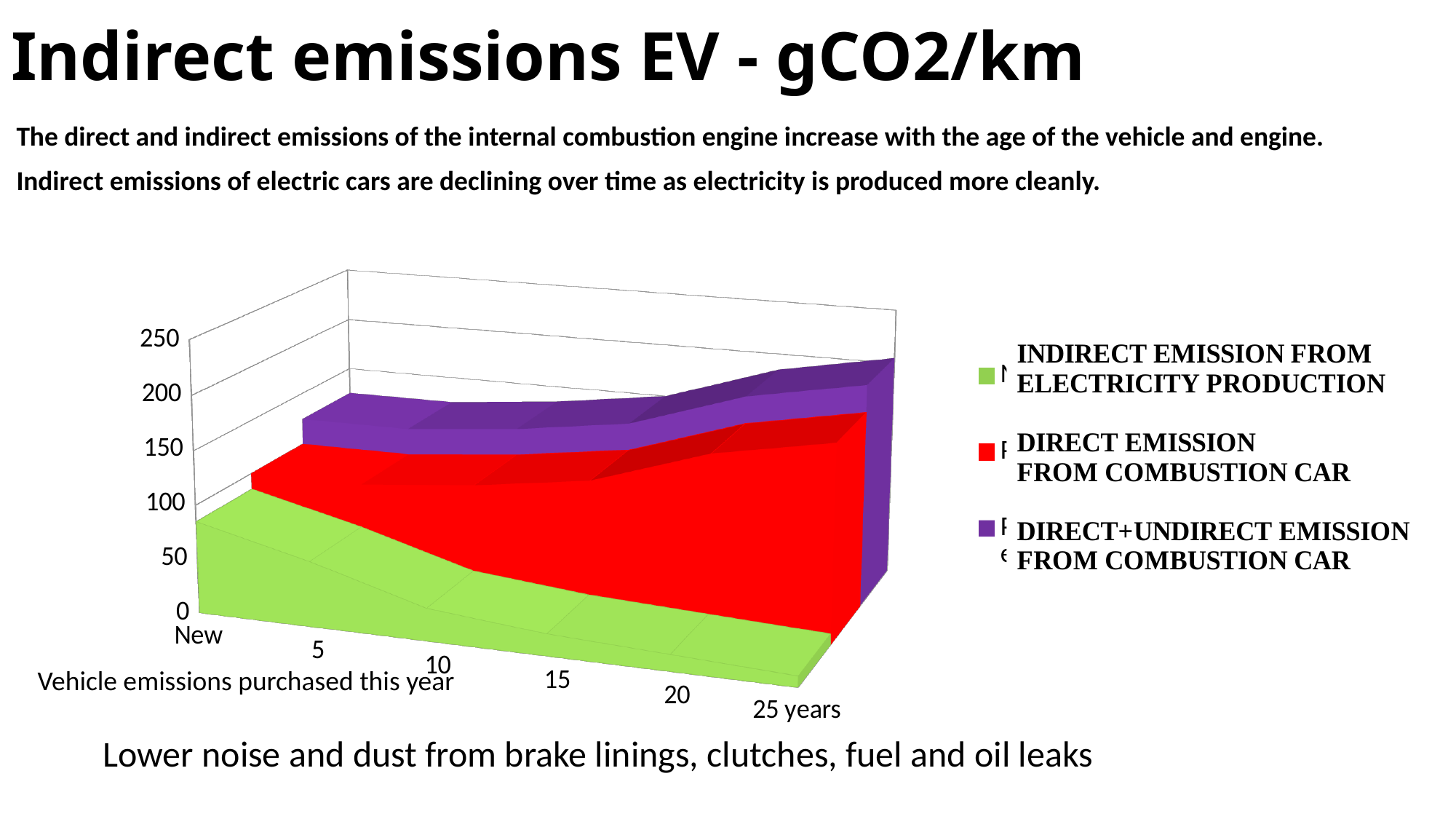
What is the first category on the x axis of the chart? New Is the value for 'INDIRECT EMISSION FROM ELECTRICITY PRODUCTION' at 25 years greater or less than 50? less Does the 'INDIRECT EMISSION FROM ELECTRICITY PRODUCTION' series rise or fall from New to 25 years? fall Does the 'DIRECT EMISSION FROM COMBUSTION CAR' series rise or fall from New to 25 years? rise Which category has the highest value for 'INDIRECT EMISSION FROM ELECTRICITY PRODUCTION'? New Which category has the lowest value for 'INDIRECT EMISSION FROM ELECTRICITY PRODUCTION'? 25 years Is the value for 'INDIRECT EMISSION FROM ELECTRICITY PRODUCTION' at New greater or less than 50? greater How many series does the chart's legend list? 3 How many categories are shown along the x axis of the chart? 6 What is the highest tick value shown on the vertical axis of the chart? 250 What is the last category on the x axis of the chart? 25 years What kind of chart is shown on the slide? area chart